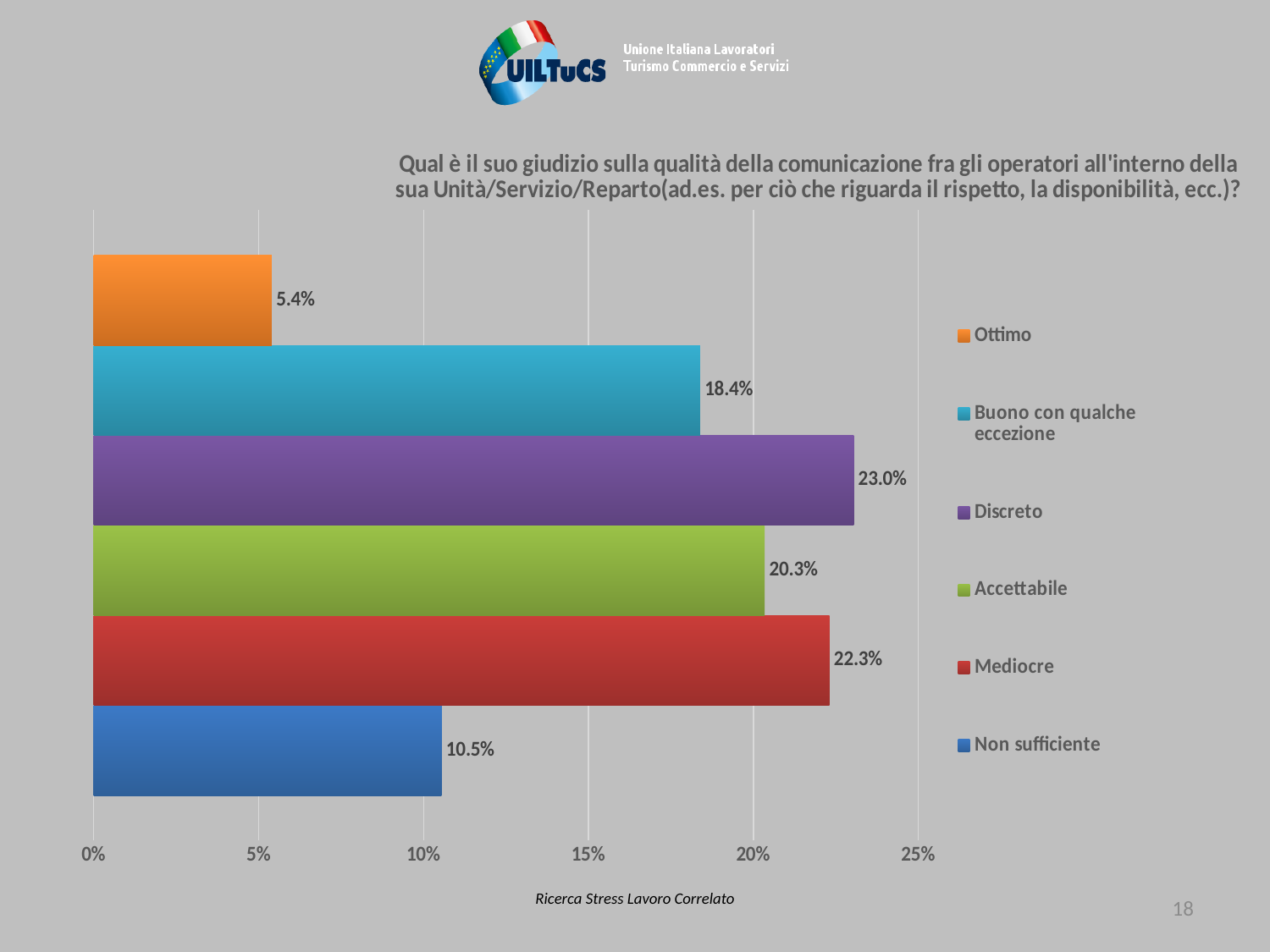
What colour is the bar for Accettabile? green What is the value for Buono con qualche eccezione? 18.4% Is the value for Mediocre greater or less than 20%? greater What is the value for Non sufficiente? 10.5% How many categories are shown in the chart? 6 Which category has the lowest value? Ottimo What kind of chart is shown on the slide? bar chart Which is larger, the value for Buono con qualche eccezione or the value for Non sufficiente? Buono con qualche eccezione What is the value for Discreto? 23.0% What is the value for Ottimo? 5.4% Which category has the highest value? Discreto What is the difference between the values for Mediocre and Accettabile? 2.0%